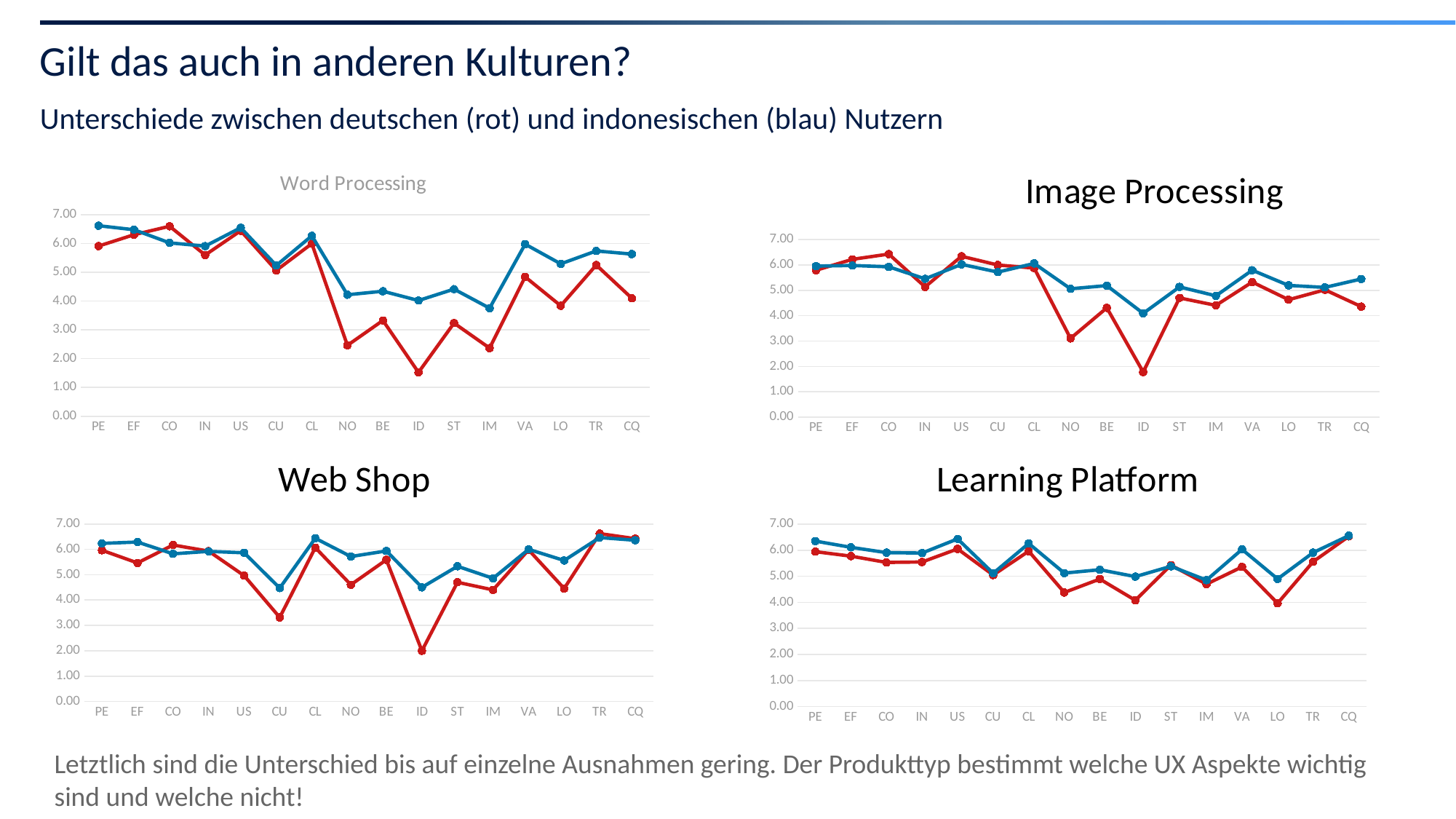
How many categories are shown on the x axis of the Web Shop chart? 16 What kind of chart is the Word Processing chart? line chart In the Word Processing chart, is the red value for ID greater or less than 2.00? less In the Web Shop chart, is the red value for CU greater or less than 4.00? less In the Learning Platform chart, is the red value for NO greater or less than 5.00? less In the Image Processing chart, which line is higher at NO, the red or the blue? blue In the Word Processing chart, which line is higher at ID, the red or the blue? blue In the Word Processing chart, at which category does the red line reach its lowest value? ID In the Image Processing chart, at which category does the red line reach its lowest value? ID According to the slide subtitle, which colour represents the German users? red